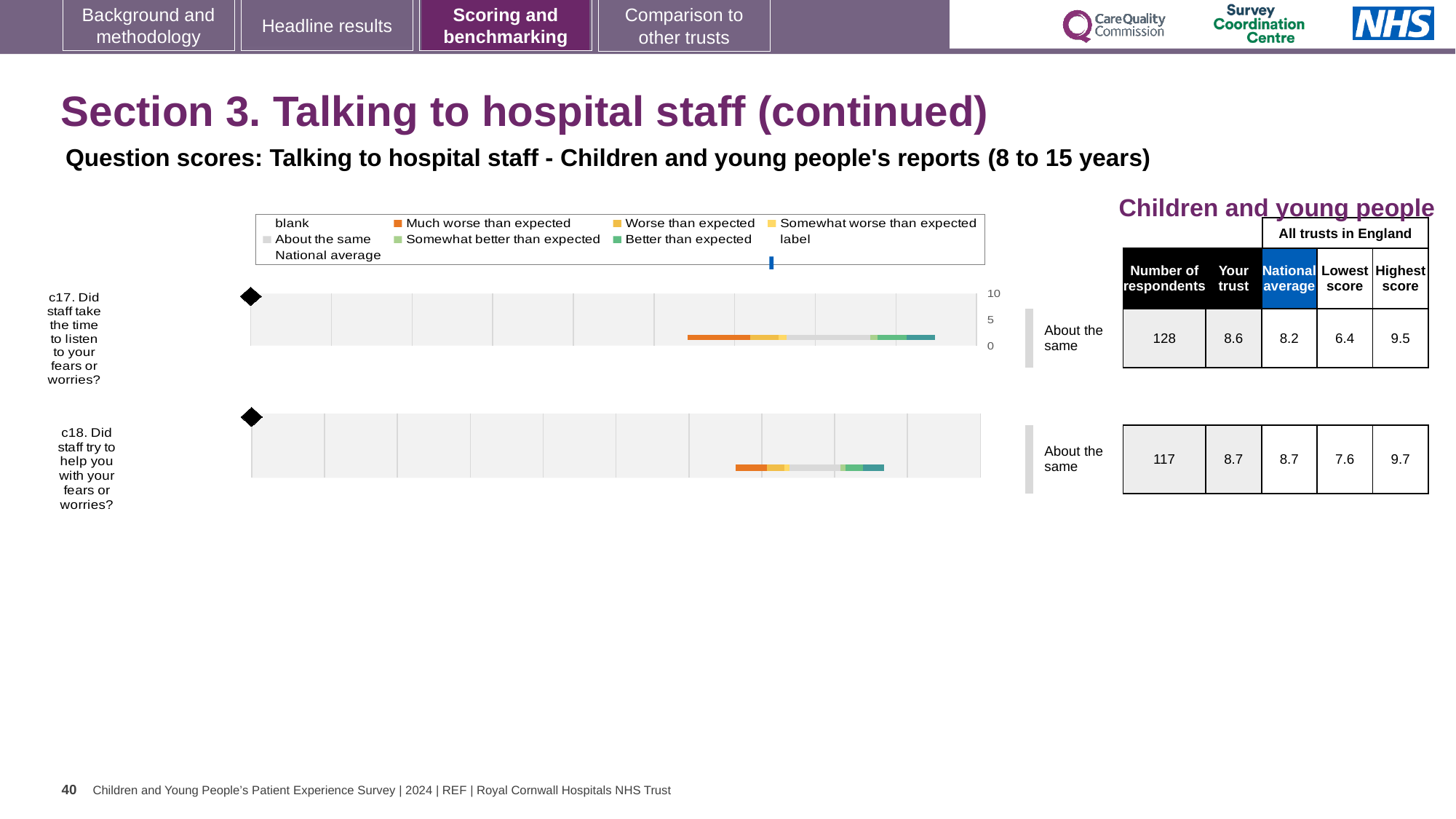
What is the national average score for question c17? 8.2 What is the 'Your trust' score for question c17 (Did staff take the time to listen to your fears or worries?)? 8.6 Which question has the higher 'Your trust' score, c17 or c18? c18 What is the maximum value shown on the score axis of the charts? 10 What is the number of respondents for question c18? 117 What is the 'Your trust' score for question c18 (Did staff try to help you with your fears or worries?)? 8.7 What is the lowest score among all trusts in England for question c18? 7.6 What kind of chart is used to show the benchmarking results for questions c17 and c18? bar chart How many survey questions are plotted on the slide? 2 What is the highest score among all trusts in England for question c17? 9.5 What is the difference between the trust score and the national average for question c17? 0.4 What benchmarking category is shown for question c17? About the same